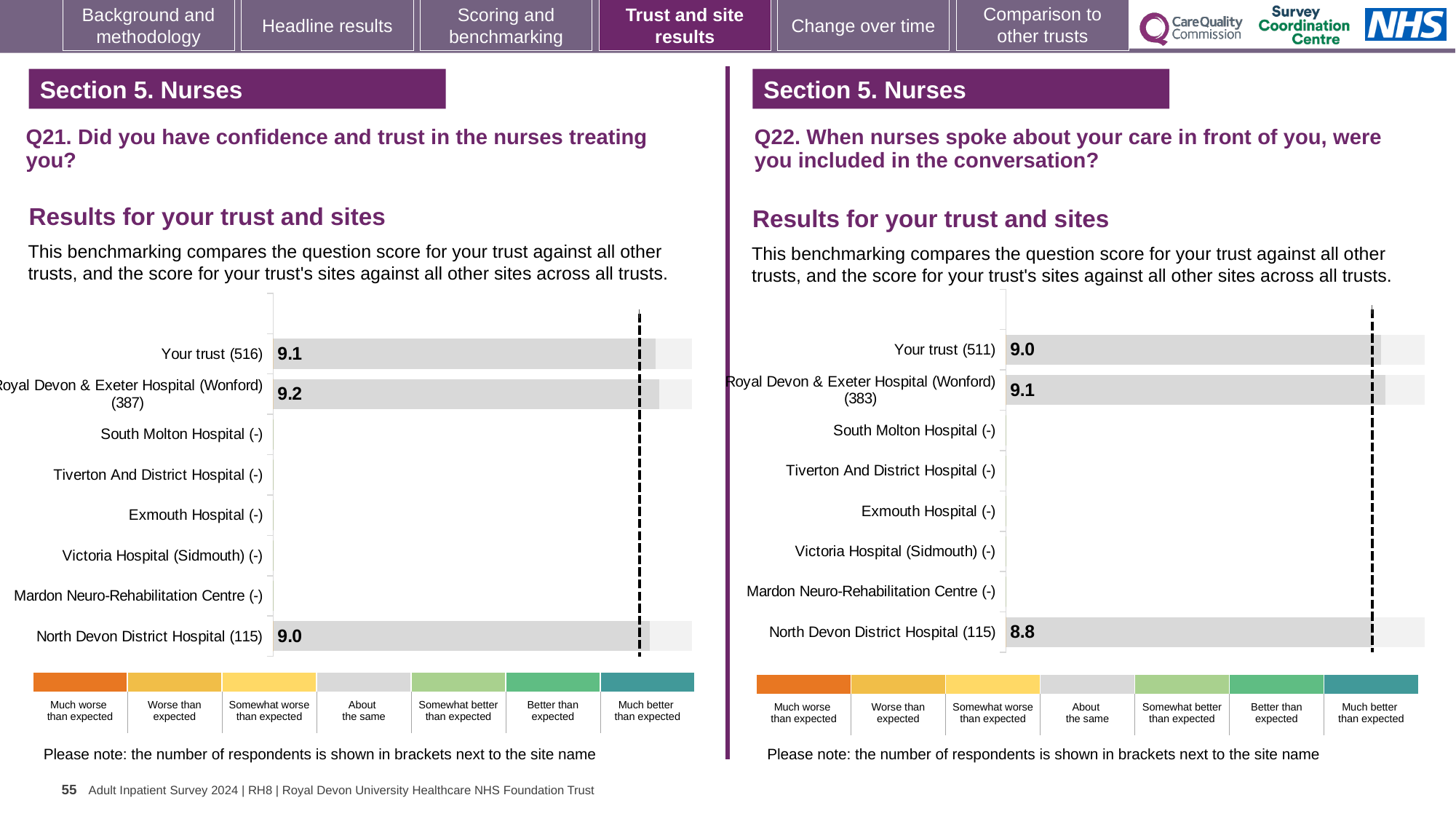
How many site or trust rows are listed on the Q21 chart (left)? 8 On the Q21 chart (left), what is the score for North Devon District Hospital (115)? 9.0 On the Q21 chart (left), what is the difference between the scores for Royal Devon & Exeter Hospital (Wonford) and North Devon District Hospital? 0.2 On the Q21 chart (left), what is the score for Royal Devon & Exeter Hospital (Wonford) (387)? 9.2 On the Q21 chart (left), what is the score for Your trust (516)? 9.1 On the Q22 chart (right), what is the score for North Devon District Hospital (115)? 8.8 On the Q21 chart (left), which has the higher score: Your trust or North Devon District Hospital? Your trust What kind of chart is used on the Q22 chart (right)? Bar chart On the Q22 chart (right), which site or trust row has the highest score? Royal Devon & Exeter Hospital (Wonford) (383) On the Q22 chart (right), what is the score for Your trust (511)? 9.0 On the Q22 chart (right), what is the difference between the scores for Your trust and North Devon District Hospital? 0.2 On the Q22 chart (right), which site or trust row has the lowest score shown? North Devon District Hospital (115)